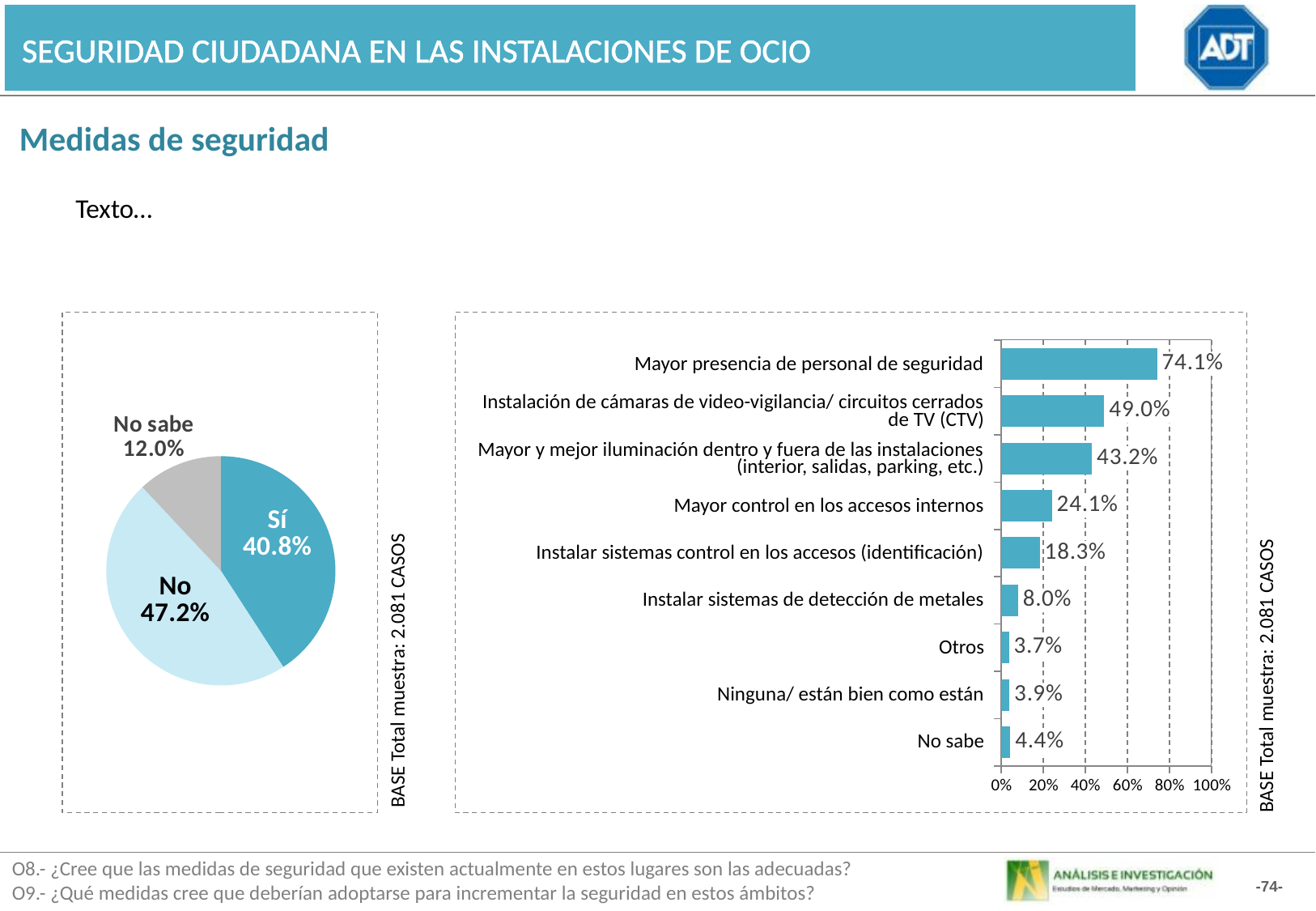
In the bar chart on the right, what is the value for 'Instalar sistemas de detección de metales'? 8.0% In the bar chart on the right, which is larger: 'Mayor control en los accesos internos' or 'Instalar sistemas control en los accesos (identificación)'? Mayor control en los accesos internos What type of chart is shown on the right side of the slide? Bar chart In the pie chart on the left, which response has the largest share? No In the pie chart on the left, how many slices are there? 3 In the bar chart on the right, how many categories are shown? 9 In the bar chart on the right, what is the difference between 'Instalación de cámaras de video-vigilancia/ circuitos cerrados de TV (CTV)' and 'Mayor y mejor iluminación dentro y fuera de las instalaciones (interior, salidas, parking, etc.)'? 5.8% In the pie chart on the left, what share of respondents answered 'Sí'? 40.8% In the pie chart on the left, what share of respondents answered 'No sabe'? 12.0% In the pie chart on the left, what is the difference between the 'No' and 'Sí' shares? 6.4% In the bar chart on the right, which category has the lowest value? Otros In the bar chart on the right, what is the value for 'Mayor presencia de personal de seguridad'? 74.1%